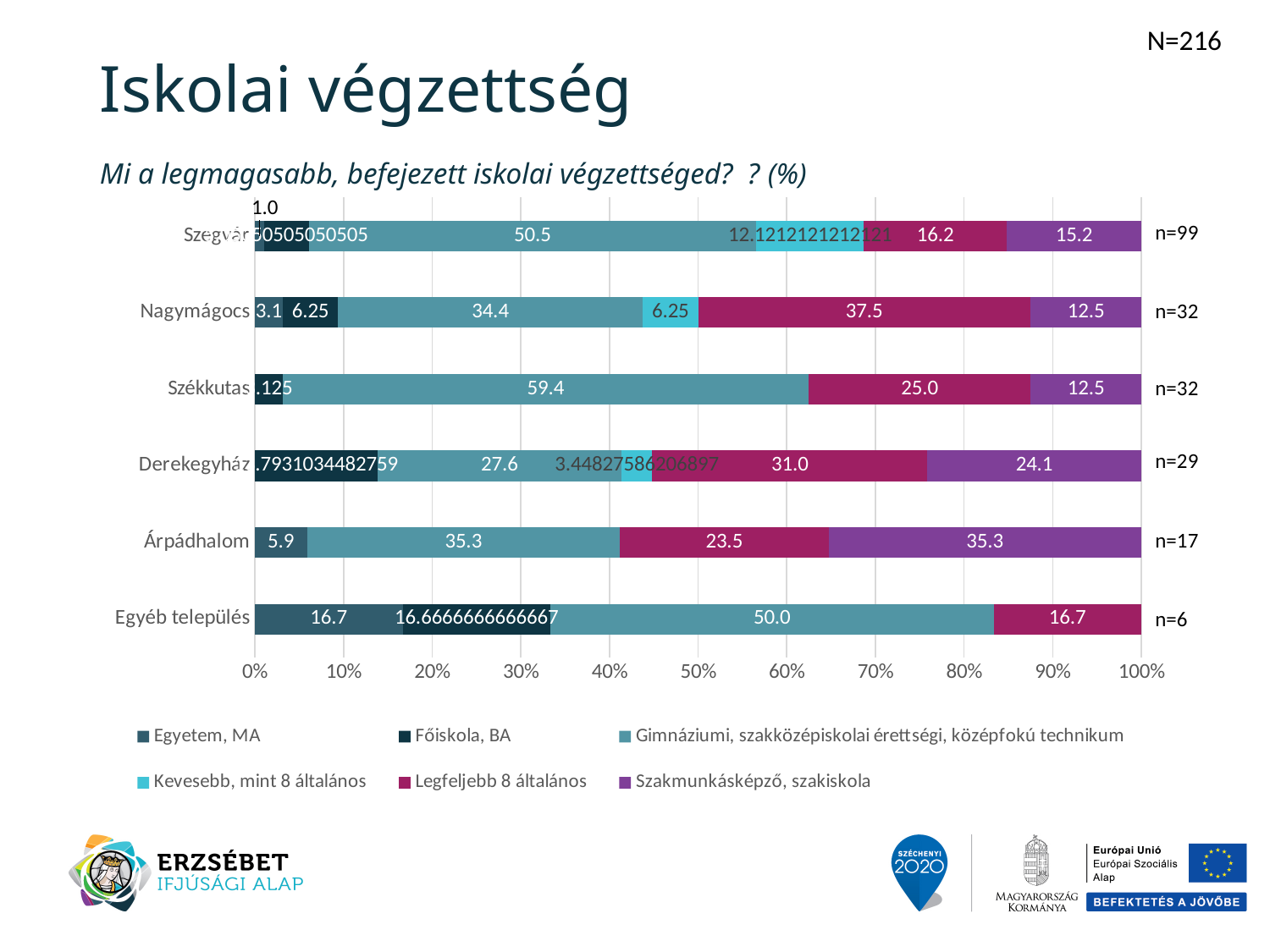
What is the value for 'Szakmunkásképző, szakiskola' for Árpádhalom? 35.3 For Derekegyház, what is the difference between 'Legfeljebb 8 általános' (31.0) and 'Szakmunkásképző, szakiskola' (24.1)? 6.9 How many series does the chart legend list? 6 For Nagymágocs, which is larger: 'Legfeljebb 8 általános' or 'Szakmunkásképző, szakiskola'? Legfeljebb 8 általános What is the value for 'Gimnáziumi, szakközépiskolai érettségi, középfokú technikum' for Egyéb település? 50.0 What is the sample size (n) shown next to the Szegvár bar? n=99 How many settlements (categories) are shown on the y axis of the chart? 6 What is the value for 'Legfeljebb 8 általános' for Nagymágocs? 37.5 Which settlement has the highest value for 'Gimnáziumi, szakközépiskolai érettségi, középfokú technikum'? Székkutas What kind of chart is shown on the slide? Stacked bar chart What is the value for 'Gimnáziumi, szakközépiskolai érettségi, középfokú technikum' for Szegvár? 50.5 Which settlement has the highest value for 'Szakmunkásképző, szakiskola'? Árpádhalom